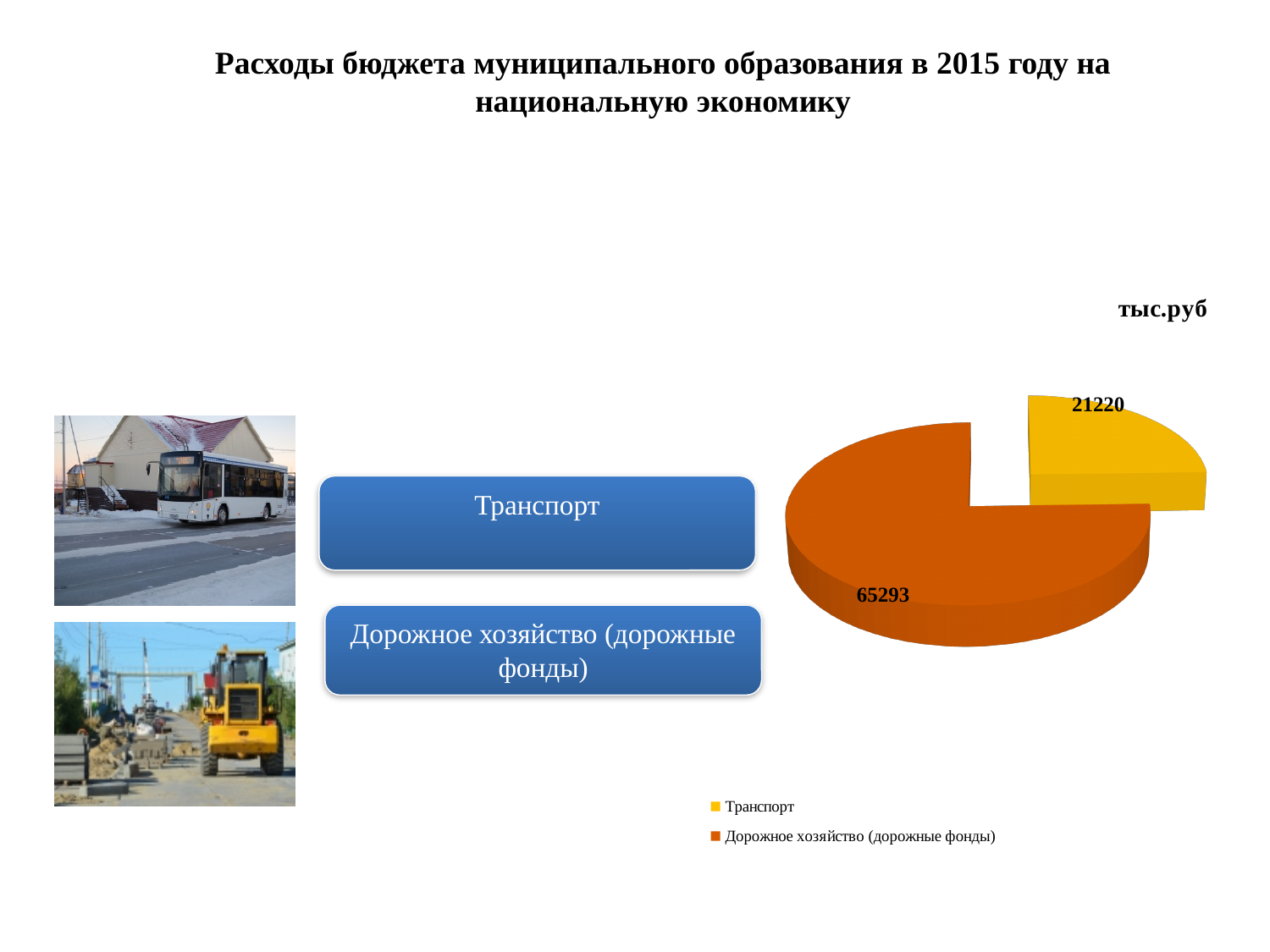
What is the difference between the values for Дорожное хозяйство (дорожные фонды) and Транспорт? 44073 Which category has the largest slice in the pie chart? Дорожное хозяйство (дорожные фонды) Which is larger: the value for Транспорт or the value for Дорожное хозяйство (дорожные фонды)? Дорожное хозяйство (дорожные фонды) What is the value for Дорожное хозяйство (дорожные фонды) in the pie chart? 65293 How many entries does the legend list? 2 What unit of measurement is indicated for the chart values? тыс.руб What is the value for Транспорт in the pie chart? 21220 What type of chart is shown on the slide? pie chart Which category has the smallest slice in the pie chart? Транспорт How many slices does the pie chart have? 2 What is the total of the two values shown in the pie chart? 86513 What colour is the Транспорт slice in the pie chart? yellow